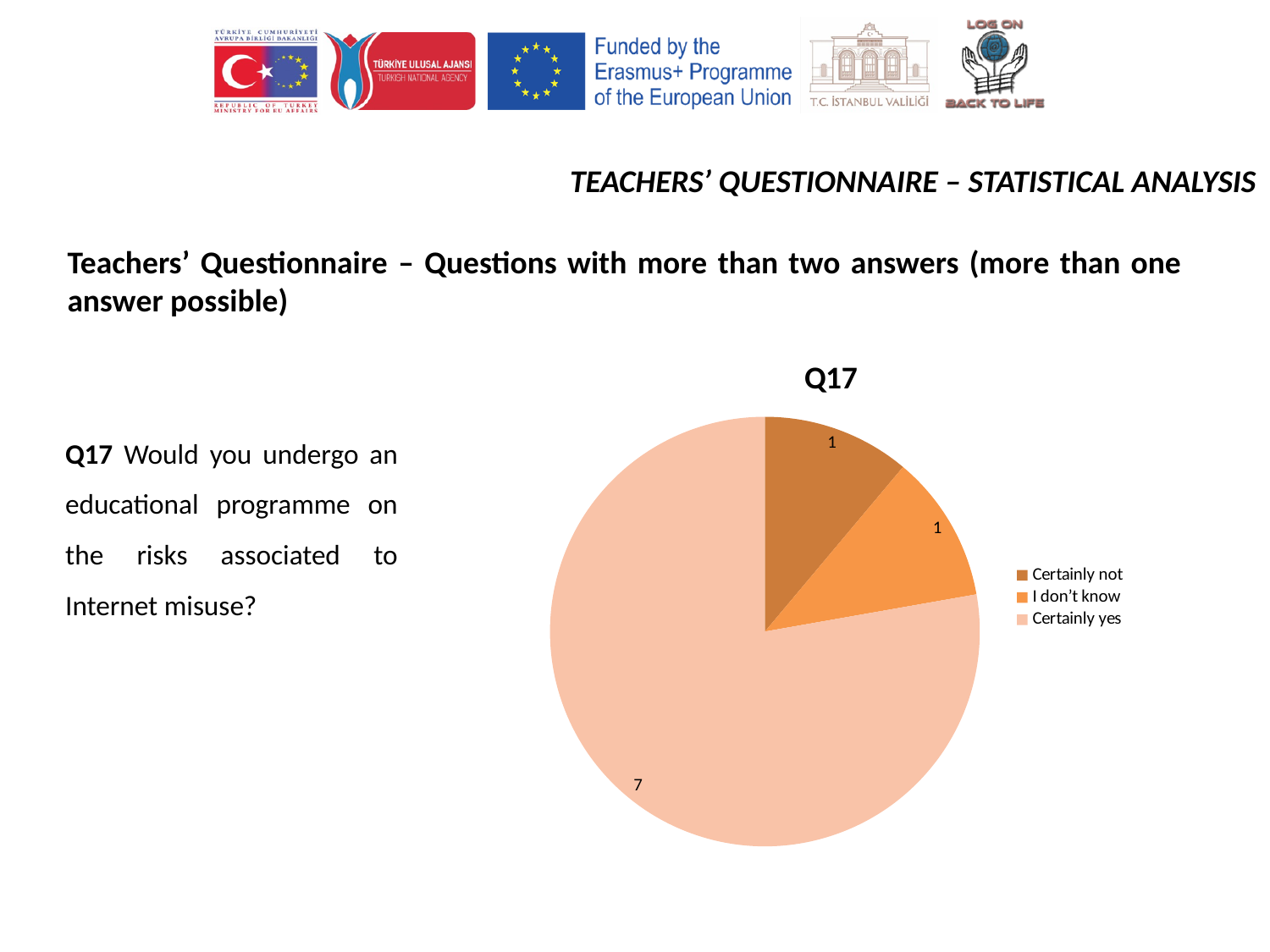
Which is larger, the value for 'Certainly yes' or the value for 'Certainly not'? Certainly yes What is the difference between the values for 'Certainly yes' and 'I don't know'? 6 What is the value for 'Certainly not'? 1 What share of the total responses does 'Certainly yes' represent? 7 out of 9 What is the value for 'I don't know'? 1 What type of chart is shown on the slide? pie chart How many entries does the legend list? 3 What is the total of all slices in the pie chart? 9 What is the value for 'Certainly yes'? 7 Which answer has the largest slice of the pie? Certainly yes How many slices does the pie chart have? 3 What is the title of the chart? Q17